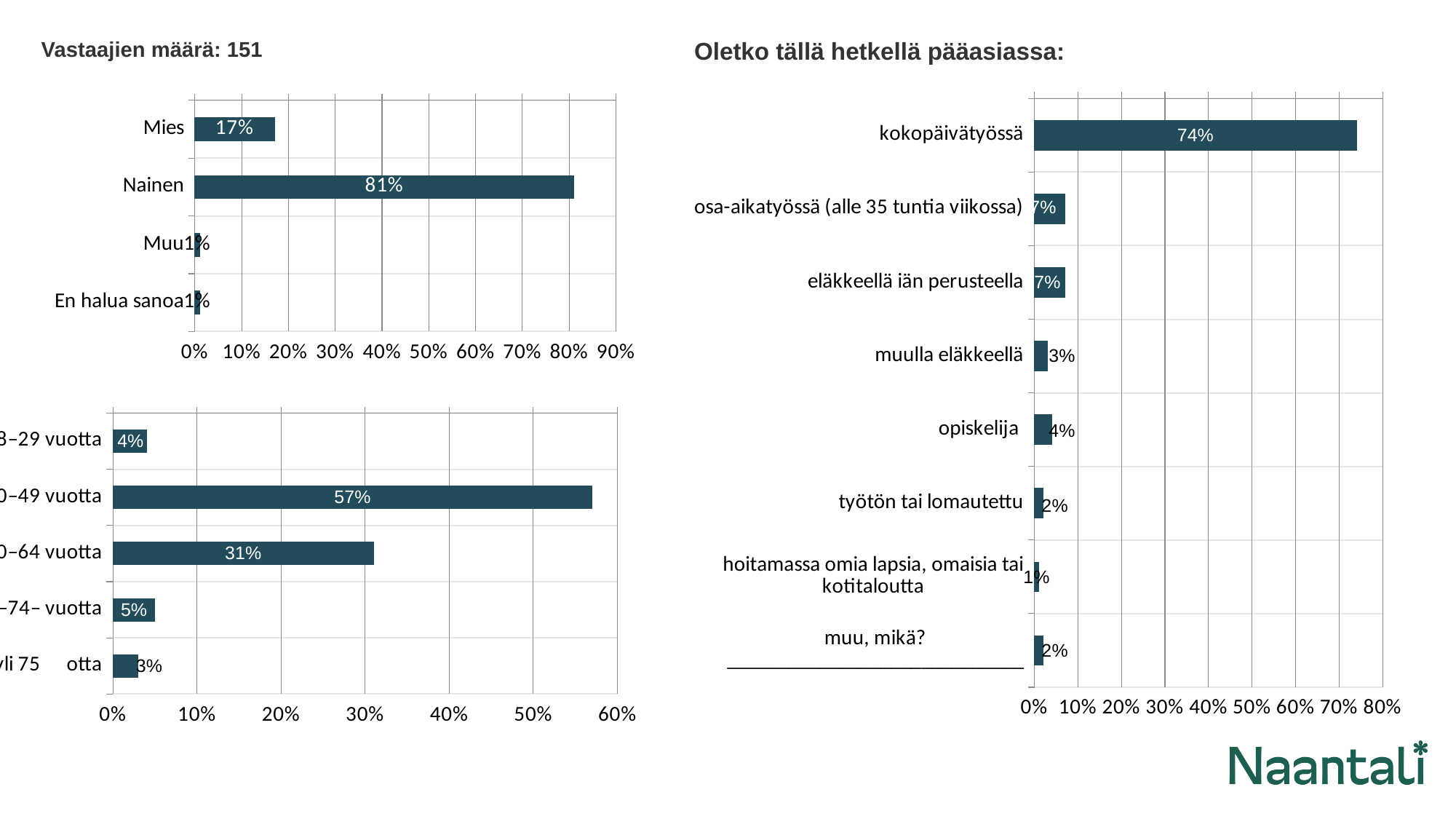
In the chart titled 'Oletko tällä hetkellä pääasiassa:', what is the value for kokopäivätyössä? 74% In the top-left chart, what is the value for Nainen? 81% What kind of chart is the top-left chart? bar chart In the top-left chart, what is the value for Mies? 17% In the chart titled 'Oletko tällä hetkellä pääasiassa:', what is the value for opiskelija? 4% In the chart titled 'Oletko tällä hetkellä pääasiassa:', how many categories are shown? 8 In the bottom-left chart, what is the highest value shown? 57% In the chart titled 'Oletko tällä hetkellä pääasiassa:', which category has the lowest value? hoitamassa omia lapsia, omaisia tai kotitaloutta In the top-left chart, what is the difference between the values for Nainen and Mies? 64% In the top-left chart, which category has the highest value? Nainen In the top-left chart, how many categories are shown? 4 In the chart titled 'Oletko tällä hetkellä pääasiassa:', which is larger: muulla eläkkeellä or opiskelija? opiskelija